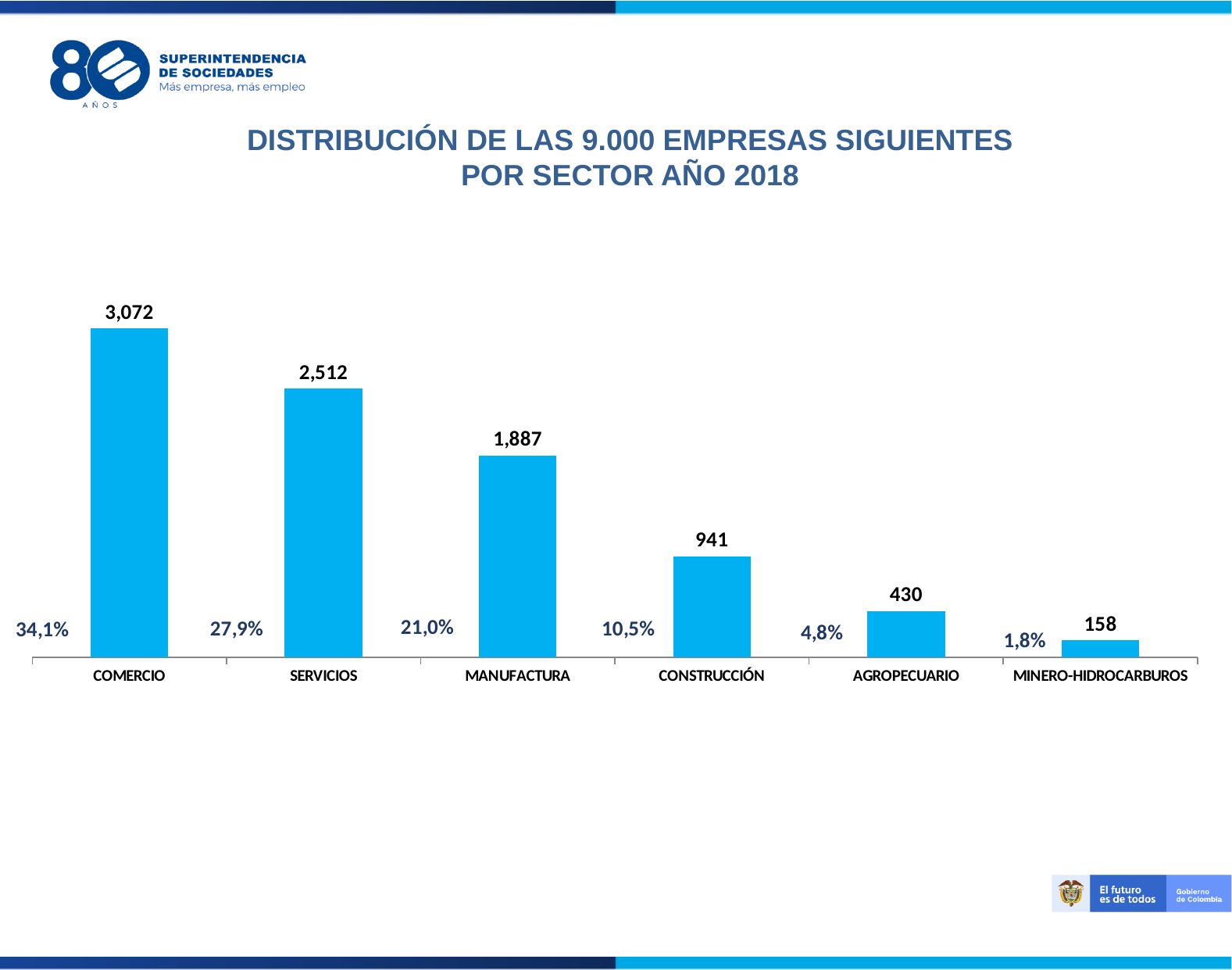
Which sector has the highest value? COMERCIO What percentage is shown for SERVICIOS? 27,9% Which is larger, the value for MANUFACTURA or the value for CONSTRUCCIÓN? MANUFACTURA What is the value for MANUFACTURA? 1,887 What is the value for MINERO-HIDROCARBUROS? 158 What kind of chart is shown on the slide? Bar chart How many sectors are shown in the chart? 6 Which sector has the lowest value? MINERO-HIDROCARBUROS What percentage is shown for AGROPECUARIO? 4,8% What is the difference between the values for COMERCIO and SERVICIOS? 560 What is the difference between the values for CONSTRUCCIÓN and AGROPECUARIO? 511 What is the value for COMERCIO? 3,072